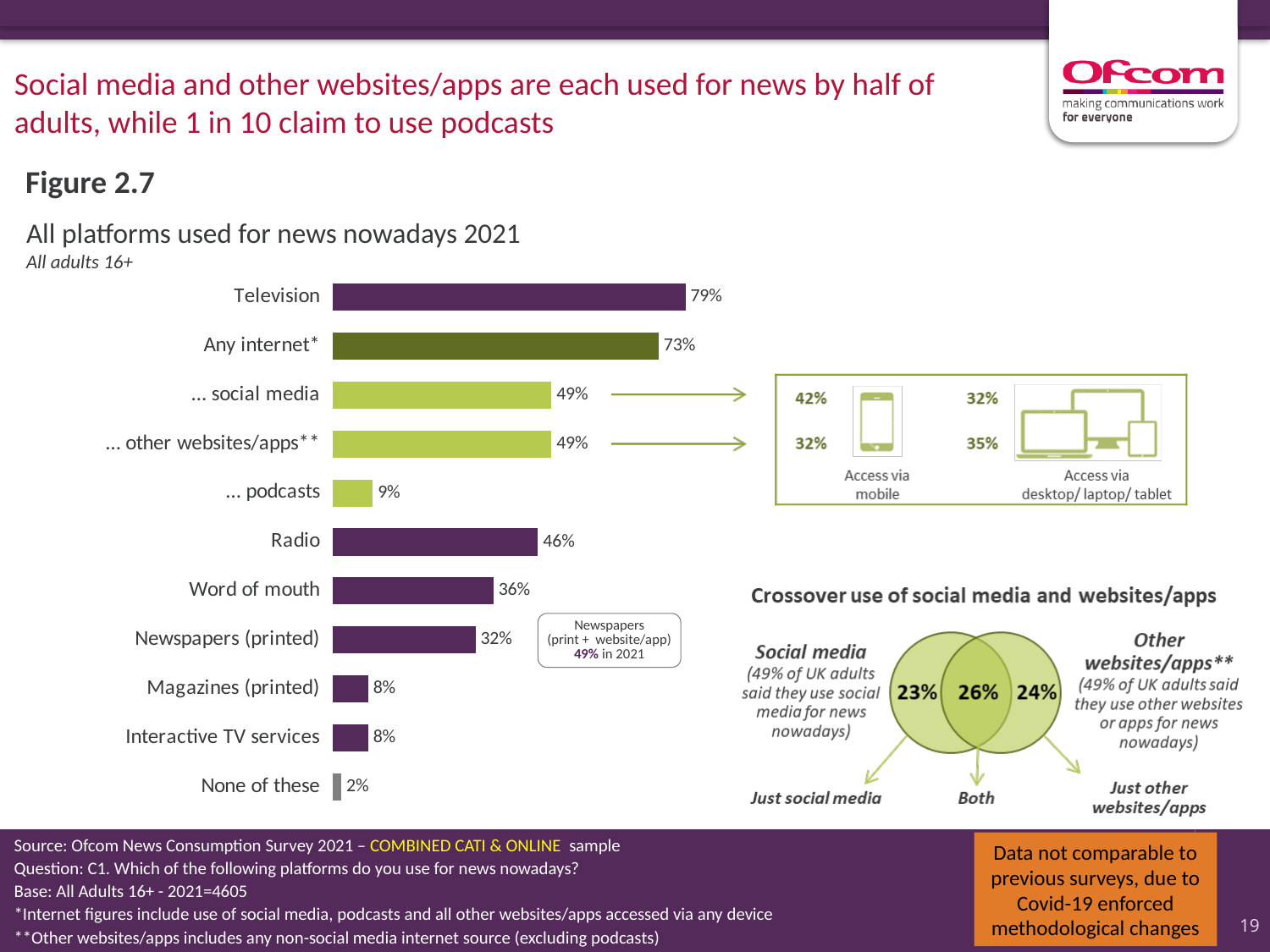
Which category has the lowest value in the bar chart? None of these Which platform has the highest percentage in the bar chart? Television What kind of chart is used to show all platforms used for news nowadays 2021? bar chart What is the difference in percentage points between Any internet and social media? 24 What percentage of adults use television for news nowadays? 79% Which is larger, the value for Radio or the value for Word of mouth? Radio How many categories are shown in the bar chart? 11 What is the value shown for podcasts? 9% What percentage of adults use printed newspapers for news? 32% What is the difference in percentage points between Television and Radio? 33 In the crossover Venn diagram, what percentage use both social media and other websites/apps for news? 26% What is the title of the bar chart? All platforms used for news nowadays 2021